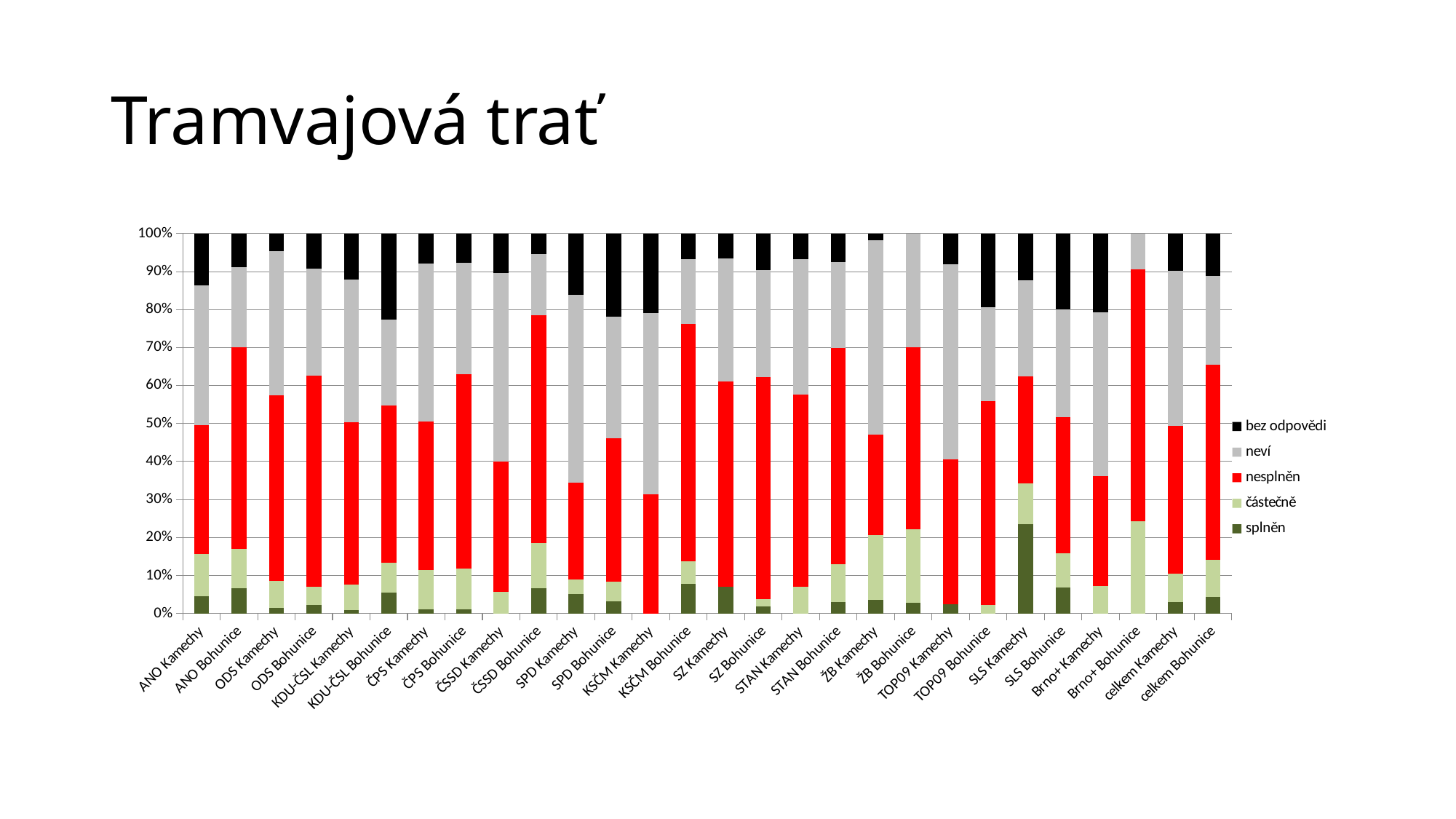
Which colour represents the 'nesplněn' series? red Is the 'nesplněn' segment for KSČM Kamechy greater or less than 40%? less Is the 'bez odpovědi' segment for ODS Kamechy greater or less than 10%? less Is the 'splněn' segment for SLS Kamechy greater or less than 20%? greater What is the title of the slide? Tramvajová trať How many series does the legend list? 5 What kind of chart is shown on the slide? stacked bar chart Which category has the largest 'splněn' segment? SLS Kamechy How many categories are shown on the x axis? 28 Which has the larger 'nesplněn' segment, SPD Kamechy or ČSSD Bohunice? ČSSD Bohunice Which has the larger 'splněn' segment, SLS Kamechy or ANO Kamechy? SLS Kamechy